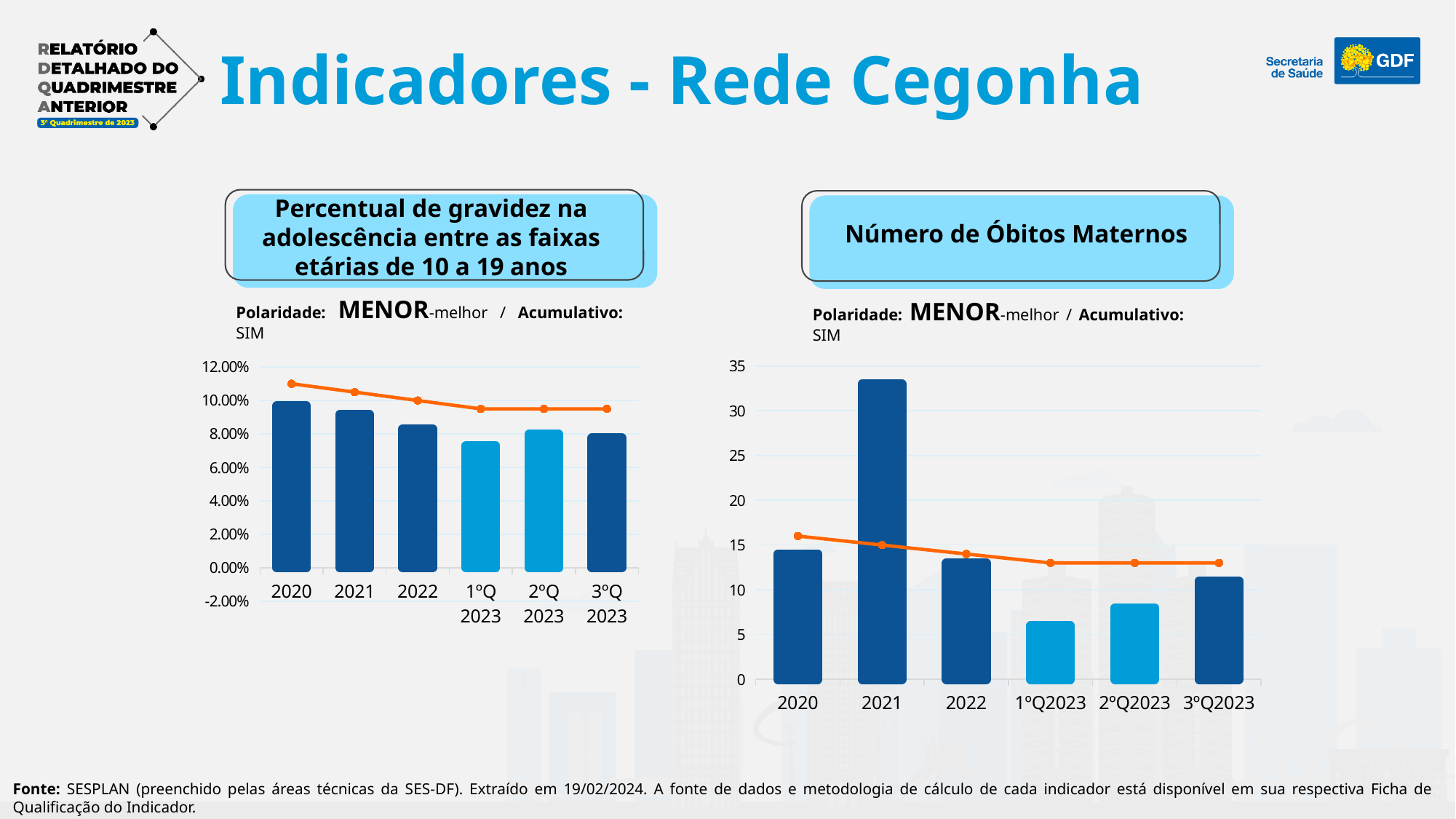
What kind of chart is 'Número de Óbitos Maternos'? Bar chart with a line In the chart 'Percentual de gravidez na adolescência entre as faixas etárias de 10 a 19 anos', which bar is taller, 2020 or 2021? 2020 In the chart 'Número de Óbitos Maternos', which bar is taller, 2ºQ2023 or 3ºQ2023? 3ºQ2023 In the chart 'Número de Óbitos Maternos', is the bar for 1ºQ2023 greater or less than 10? less In the chart 'Percentual de gravidez na adolescência entre as faixas etárias de 10 a 19 anos', which category has the lowest bar? 1ºQ 2023 How many bars are plotted in the chart 'Percentual de gravidez na adolescência entre as faixas etárias de 10 a 19 anos'? 6 In the chart 'Número de Óbitos Maternos', which category has the highest bar? 2021 In the chart 'Número de Óbitos Maternos', which category has the lowest bar? 1ºQ2023 In the chart 'Número de Óbitos Maternos', is the bar for 2021 greater or less than 30? greater In the chart 'Percentual de gravidez na adolescência entre as faixas etárias de 10 a 19 anos', is the bar for 2020 greater or less than 8.00%? greater In the chart 'Percentual de gravidez na adolescência entre as faixas etárias de 10 a 19 anos', which category has the highest bar? 2020